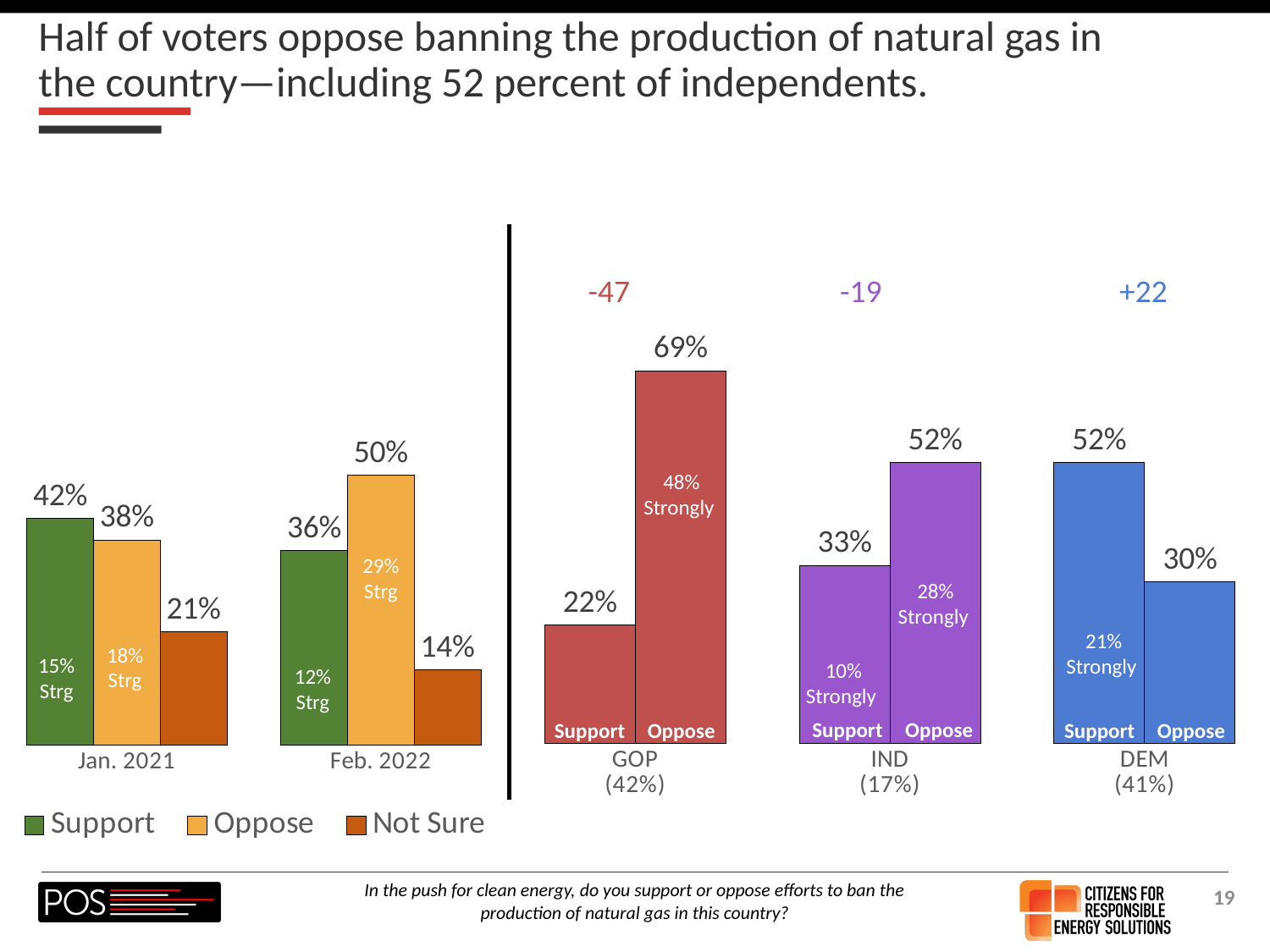
In the left chart, what is the difference between the Oppose values in Feb. 2022 and Jan. 2021? 12 points What kind of chart is shown on the left side of the slide? bar chart In the right chart, what percentage of DEM voters support the ban? 52% In the right chart, which party group has the lowest Support value? GOP In the left chart, what percentage of voters opposed banning natural gas production in Feb. 2022? 50% In the left chart, what was the Support value in Jan. 2021? 42% In the left chart, what was the Not Sure value in Feb. 2022? 14% In the left chart, how many series does the legend list? 3 In the right chart, which party group has the highest Oppose value? GOP In the left chart, did the Oppose value rise or fall from Jan. 2021 to Feb. 2022? rise In the right chart, what share of IND voters strongly oppose the ban? 28% In the right chart, what percentage of GOP voters oppose the ban? 69%